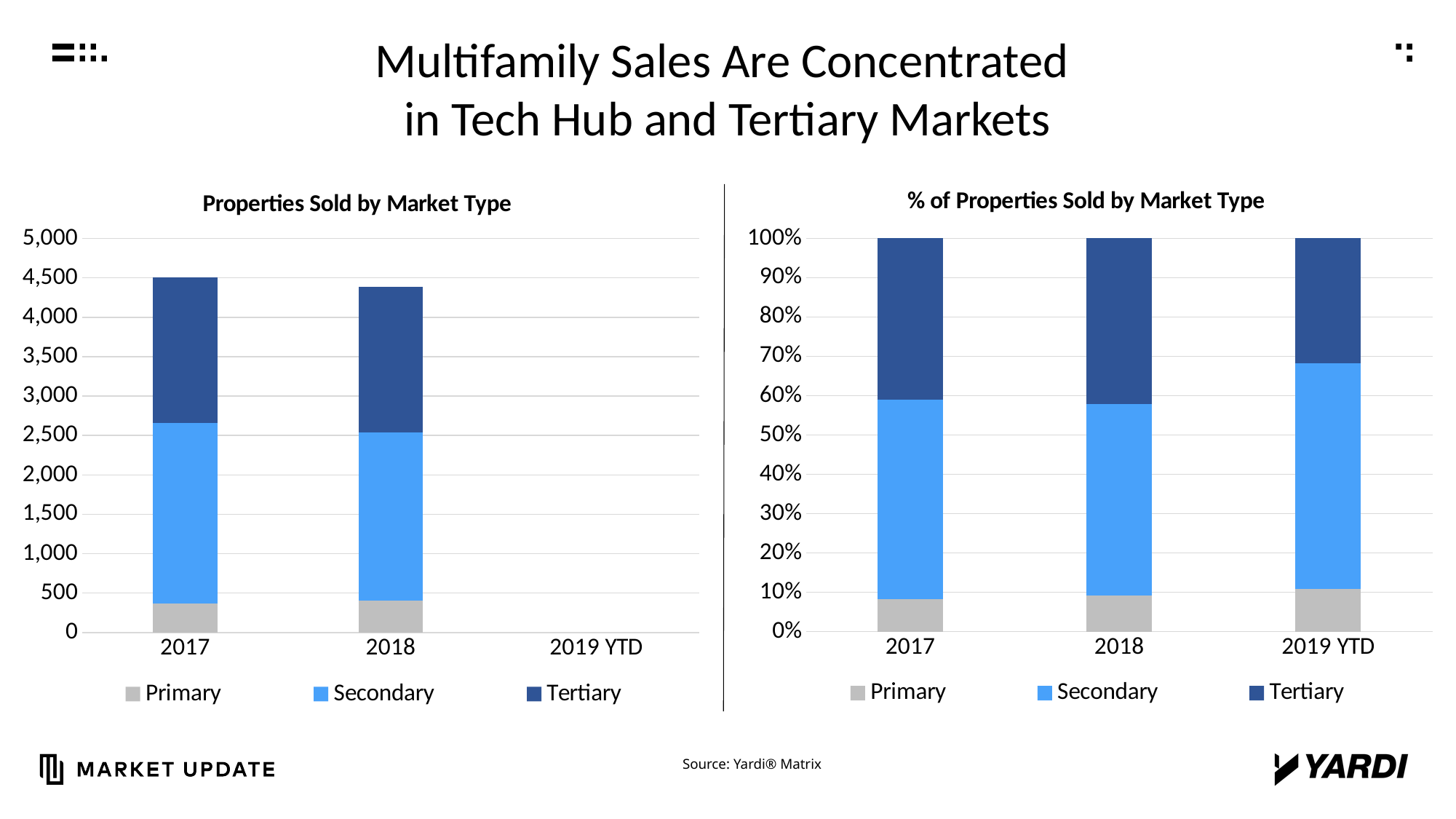
In the right chart, '% of Properties Sold by Market Type', is the Secondary share for 2019 YTD greater or less than 50%? greater In the left chart, 'Properties Sold by Market Type', is the total height of the 2017 bar greater or less than 4,000? greater Which series is shown in grey in the legends of both charts? Primary How many series does the legend of the right chart, '% of Properties Sold by Market Type', list? 3 In the left chart, 'Properties Sold by Market Type', is the Primary segment for 2017 greater or less than 500? less In the left chart, 'Properties Sold by Market Type', which year has the taller total bar, 2017 or 2018? 2017 In the right chart, '% of Properties Sold by Market Type', is the Tertiary share larger in 2017 or in 2019 YTD? 2017 In the left chart, 'Properties Sold by Market Type', how many categories are labeled on the x axis? 3 What kind of chart is the left chart, 'Properties Sold by Market Type'? Stacked bar chart In the right chart, '% of Properties Sold by Market Type', how many bars are plotted? 3